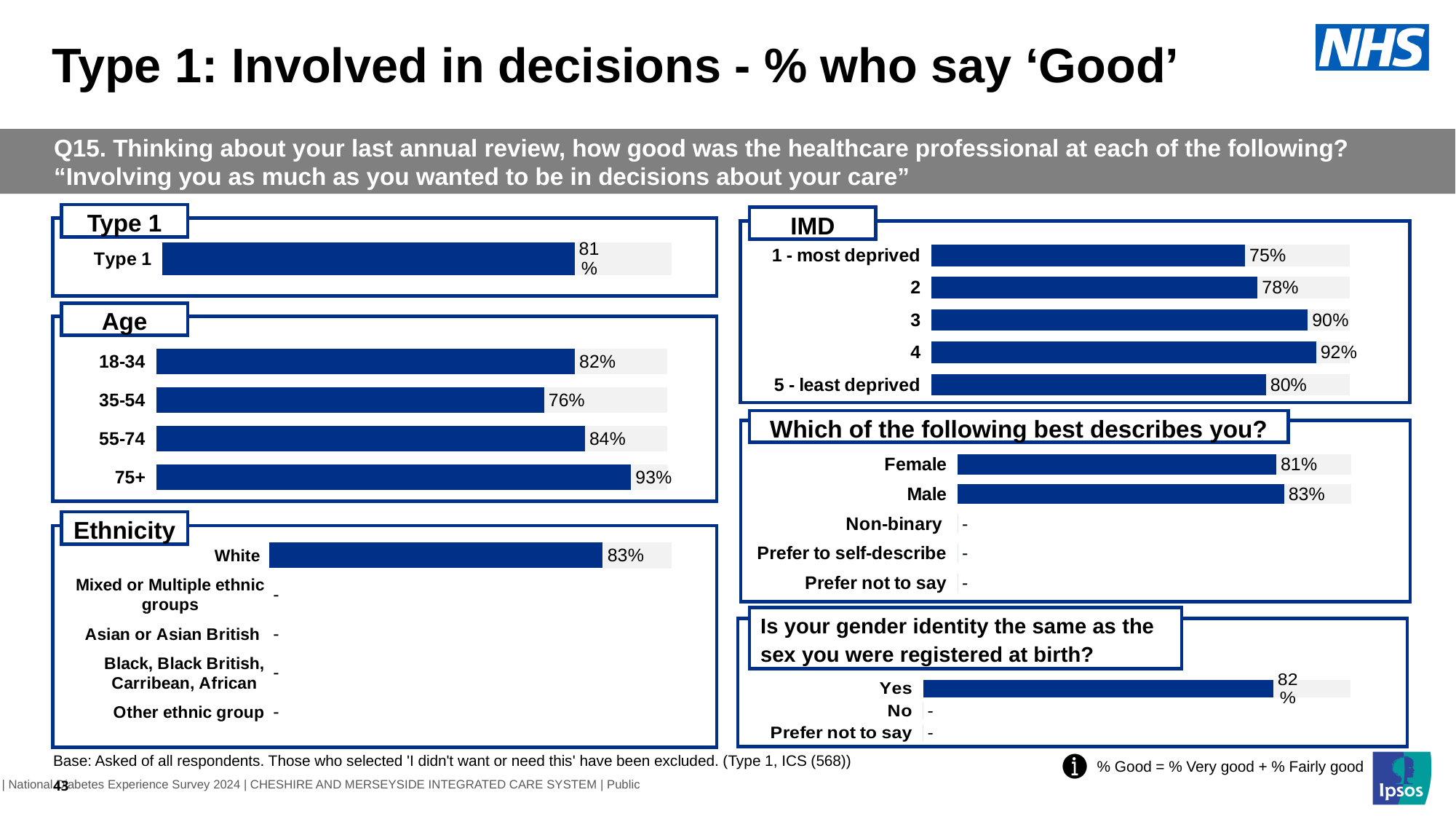
In the 'Is your gender identity the same as the sex you were registered at birth?' chart, what is the value for Yes? 82% In the IMD chart, what is the difference between the values for 4 and 1 - most deprived? 17 percentage points In the IMD chart, which category has the highest value? 4 In the IMD chart, what is the value for 1 - most deprived? 75% In the Age chart, which age group has the lowest value? 35-54 In the Ethnicity chart, how many categories are listed? 5 In the Ethnicity chart, what is the value for White? 83% In the 'Which of the following best describes you?' chart, which is larger, Female or Male? Male In the Age chart, what is the value for 75+? 93% What kind of chart is the Age chart? Bar chart In the Age chart, what is the difference between the values for 55-74 and 18-34? 2 percentage points In the Type 1 chart, what is the value for Type 1? 81%